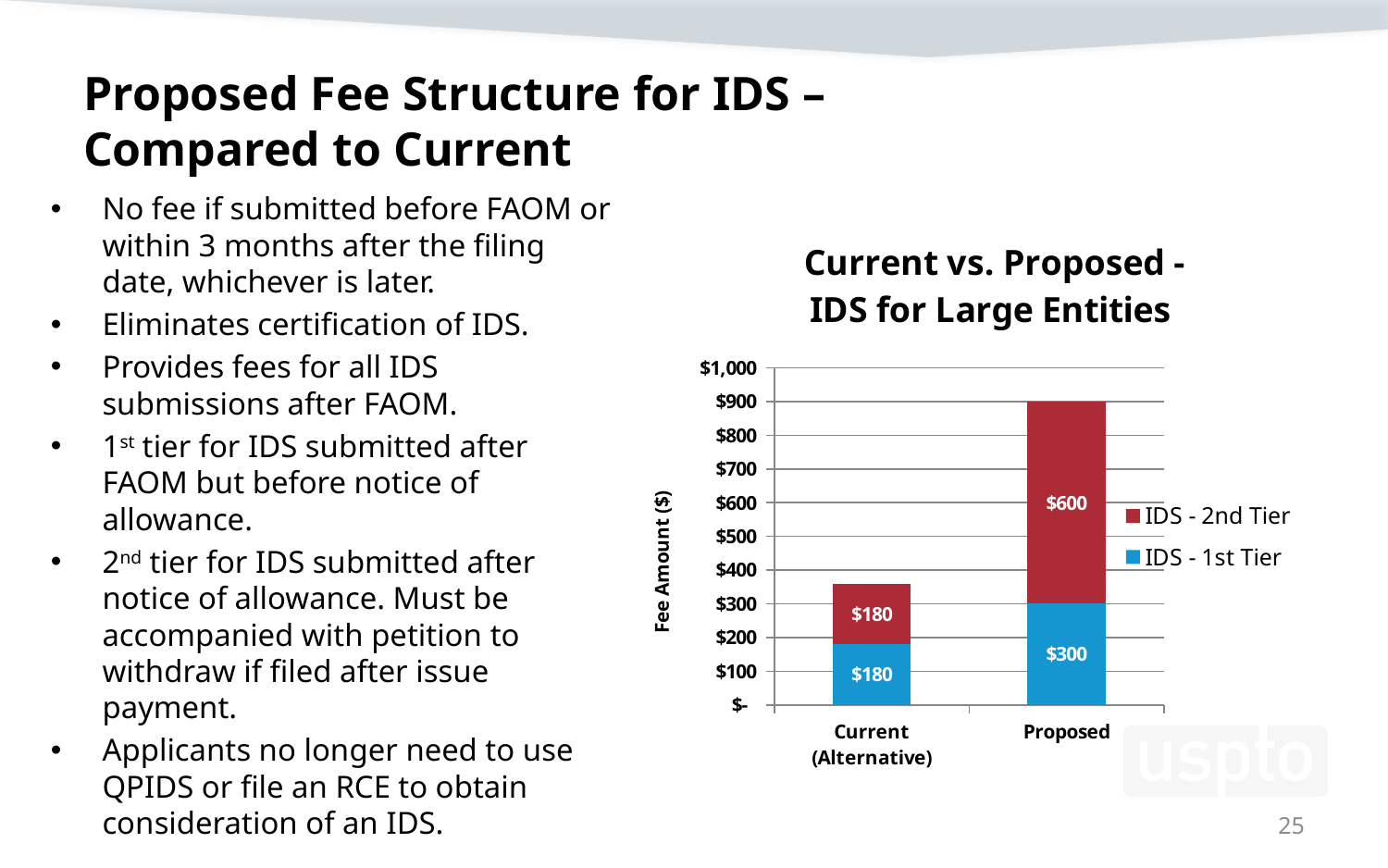
How many series does the legend list? 2 How many categories are shown on the x axis? 2 Which category has the higher total fee, Current (Alternative) or Proposed? Proposed What is the IDS - 1st Tier fee for the Proposed category? $300 What kind of chart is shown on the slide? Stacked bar chart What is the IDS - 2nd Tier fee for the Proposed category? $600 What is the total fee shown for the Proposed stacked bar? $900 What is the title of the chart? Current vs. Proposed - IDS for Large Entities How much higher is the IDS - 2nd Tier fee for Proposed than for Current (Alternative)? $420 What is the total fee shown for the Current (Alternative) stacked bar? $360 What is the IDS - 1st Tier fee for the Current (Alternative) category? $180 What is the IDS - 2nd Tier fee for the Current (Alternative) category? $180